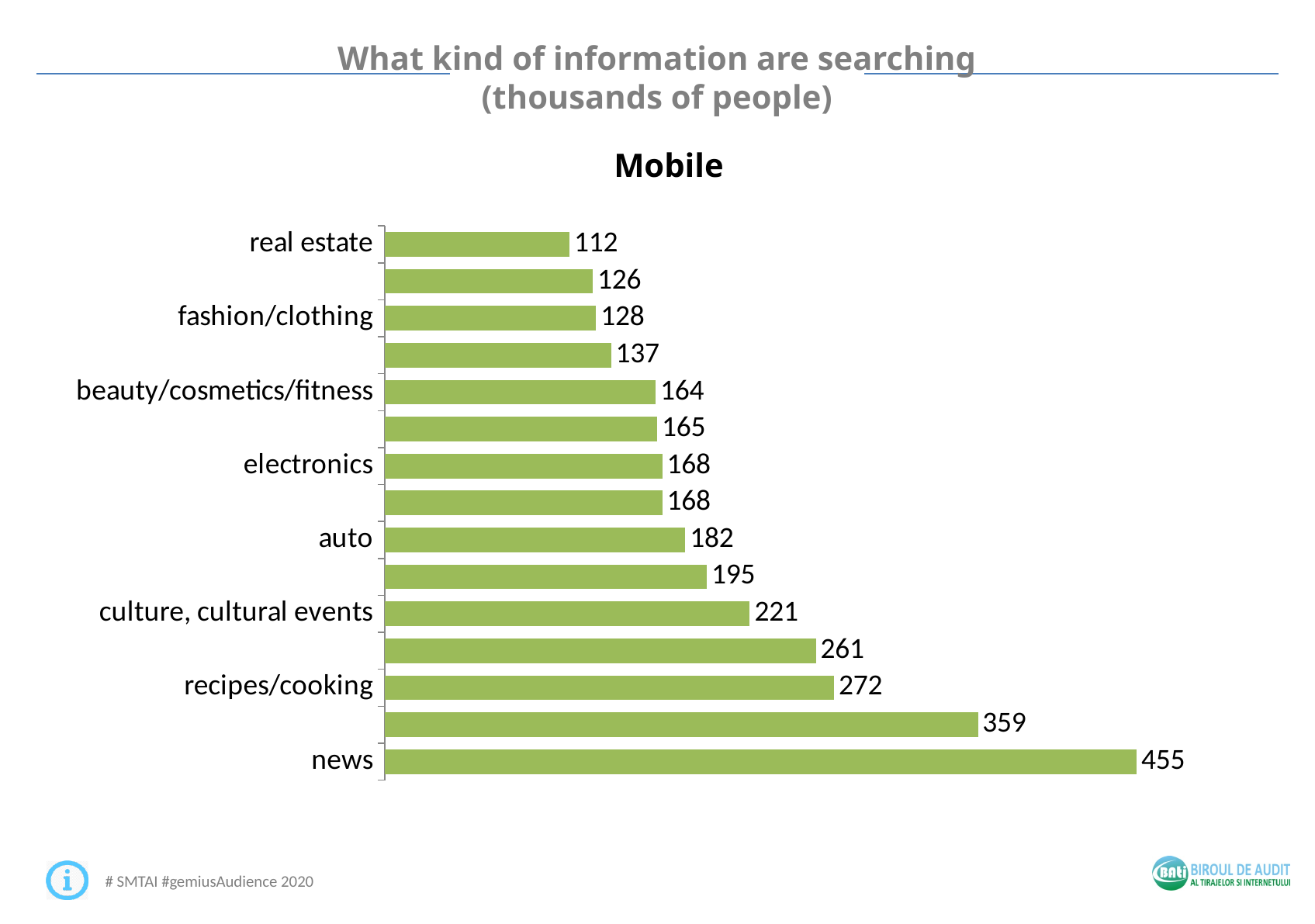
What is the value for real estate? 112 What is the difference between the values for news and recipes/cooking? 183 What is the value for beauty/cosmetics/fitness? 164 What is the value for culture, cultural events? 221 What kind of chart is shown on the slide? bar chart Which is larger, the value for auto or the value for electronics? auto Which category has the highest value? news What is the difference between the values for culture, cultural events and beauty/cosmetics/fitness? 57 What is the value for news? 455 Which category has the lowest value? real estate How many bars are plotted in the chart? 15 What is the value for recipes/cooking? 272